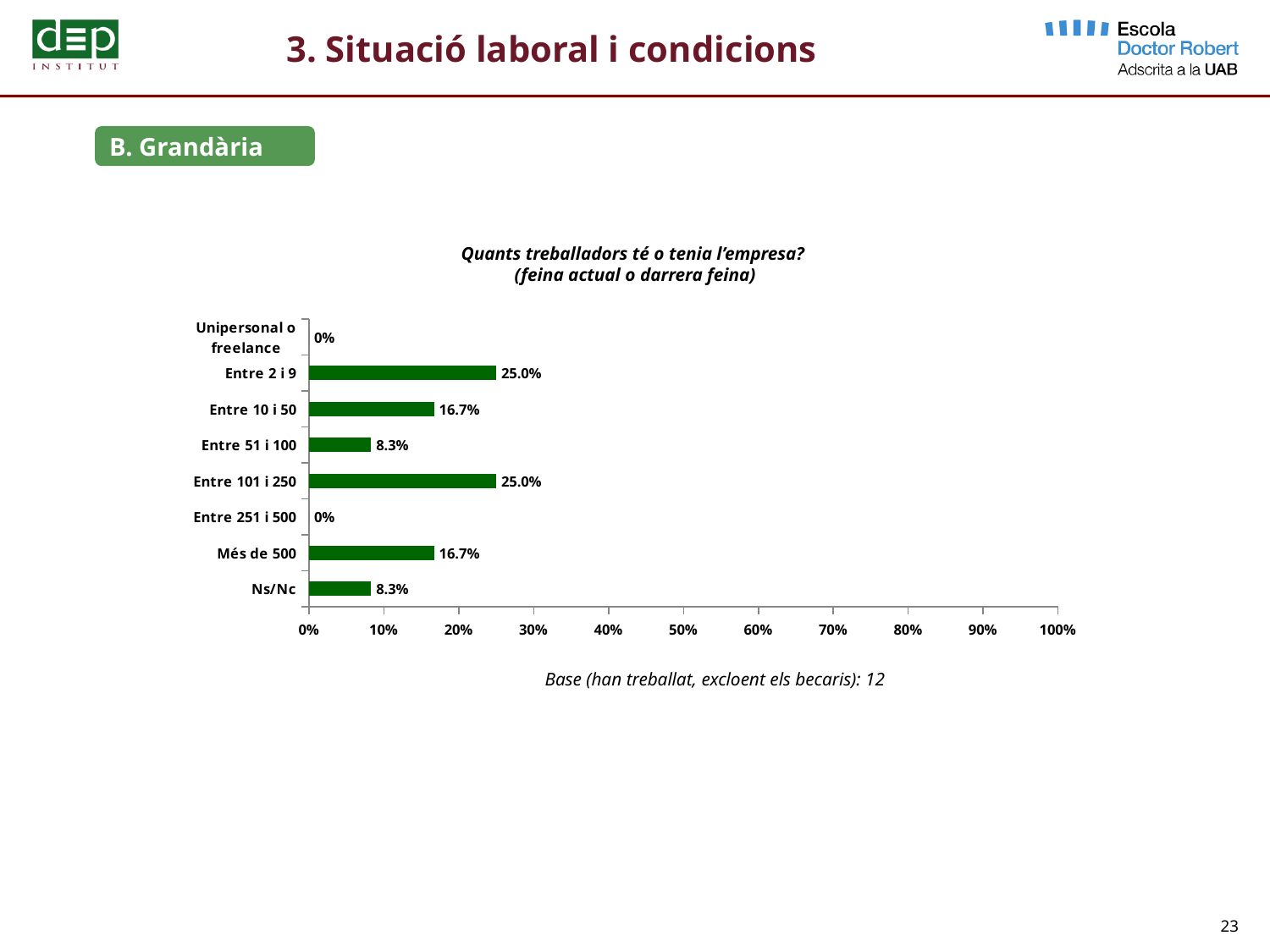
What is the value for 'Entre 10 i 50'? 16.7% What is the value for 'Més de 500'? 16.7% Which is larger, the value for 'Entre 10 i 50' or the value for 'Ns/Nc'? Entre 10 i 50 What is the value for 'Entre 251 i 500'? 0% What is the highest value shown in the chart? 25.0% How many categories are shown in the chart? 8 What kind of chart is shown on the slide? bar chart What is the value for 'Entre 2 i 9'? 25.0% What is the difference between the values for 'Entre 2 i 9' and 'Entre 51 i 100'? 16.7% What is the base (number of respondents) stated below the chart? 12 What is the value for 'Entre 51 i 100'? 8.3% Is the value for 'Entre 101 i 250' greater or less than 20%? greater